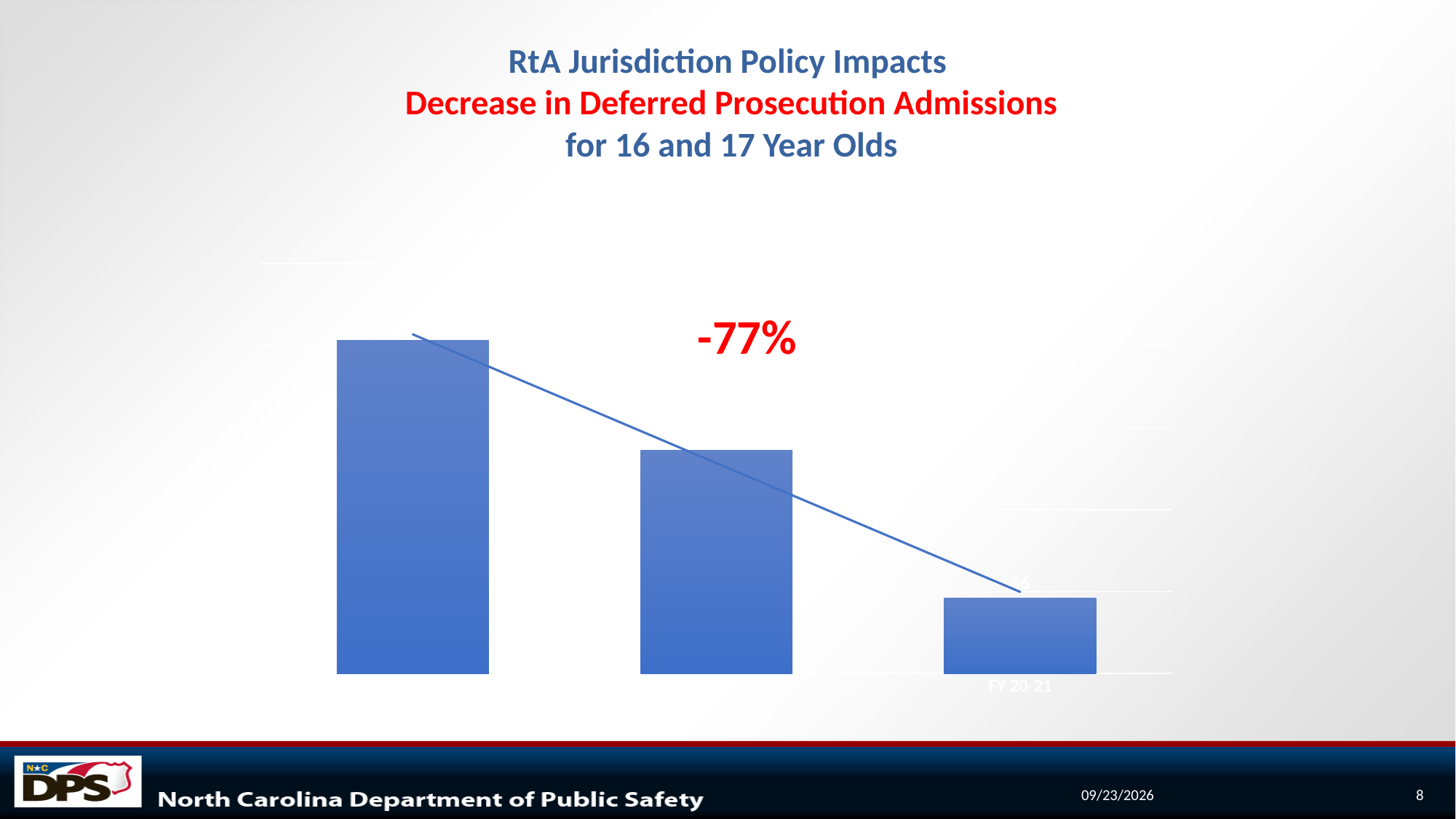
What is the red line of the slide title? Decrease in Deferred Prosecution Admissions Which bar is the tallest in the chart? the leftmost bar Which bar is the shortest in the chart? the rightmost bar (FY 20-21) What is the value shown for FY 20-21? 46 What percentage change is annotated in red on the chart? -77% What kind of chart is shown on the slide? bar chart How many bars are plotted in the chart? 3 Which is larger, the leftmost bar or the middle bar? the leftmost bar Which is larger, the middle bar or the FY 20-21 bar? the middle bar Do the bar values rise or fall from left to right across the chart? fall